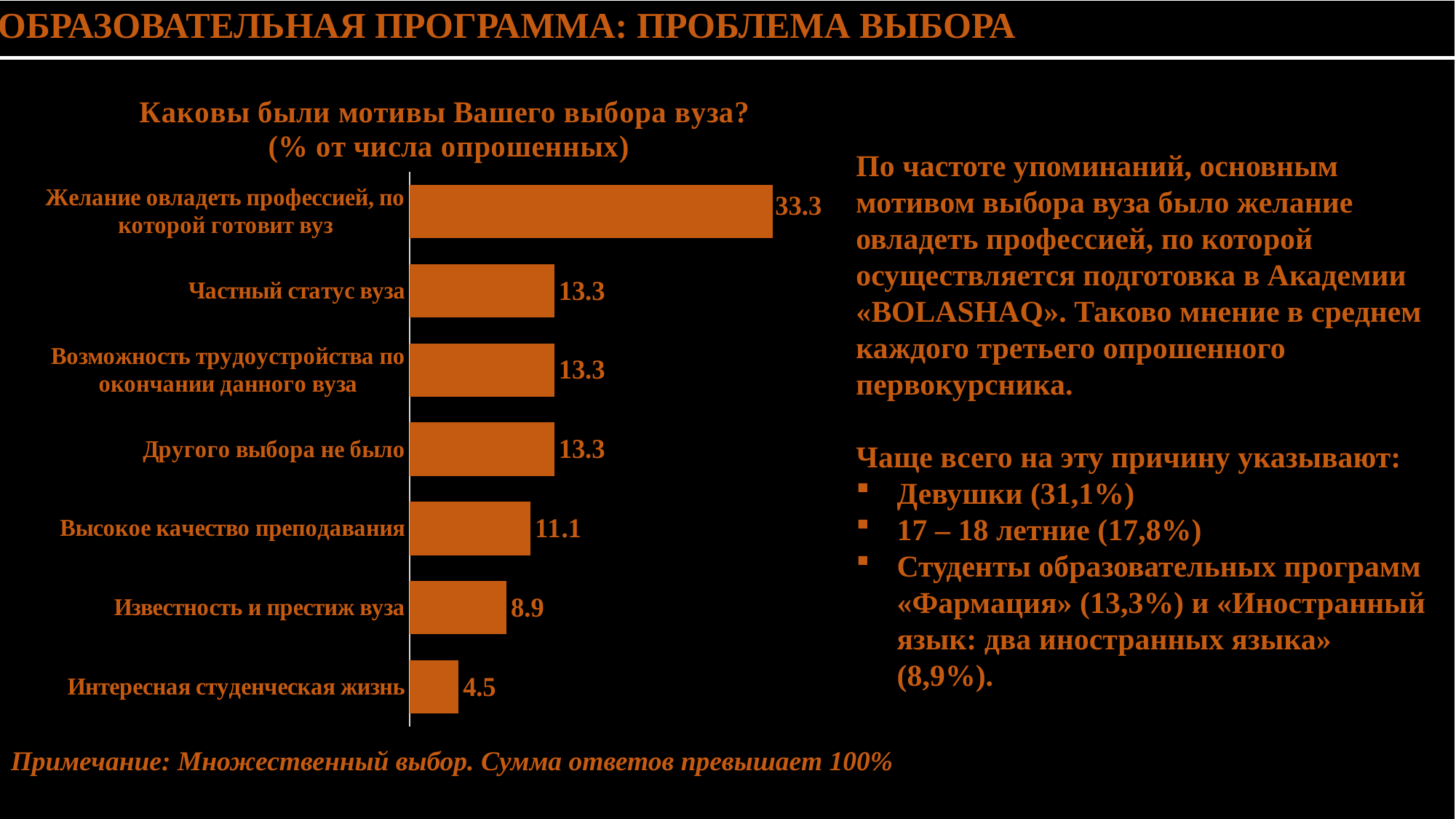
Which category has the highest value? Желание овладеть профессией, по которой готовит вуз How many categories are shown in the chart? 7 What is the value for «Частный статус вуза»? 13.3 What kind of chart is shown on the slide? Bar chart What is the value for «Желание овладеть профессией, по которой готовит вуз»? 33.3 What is the difference between the values for «Желание овладеть профессией, по которой готовит вуз» and «Интересная студенческая жизнь»? 28.8 Which category has the lowest value? Интересная студенческая жизнь What is the title of the chart? Каковы были мотивы Вашего выбора вуза? (% от числа опрошенных) What is the value for «Высокое качество преподавания»? 11.1 What is the value for «Известность и престиж вуза»? 8.9 What is the difference between the values for «Высокое качество преподавания» and «Известность и престиж вуза»? 2.2 Which is larger: the value for «Другого выбора не было» or the value for «Высокое качество преподавания»? Другого выбора не было